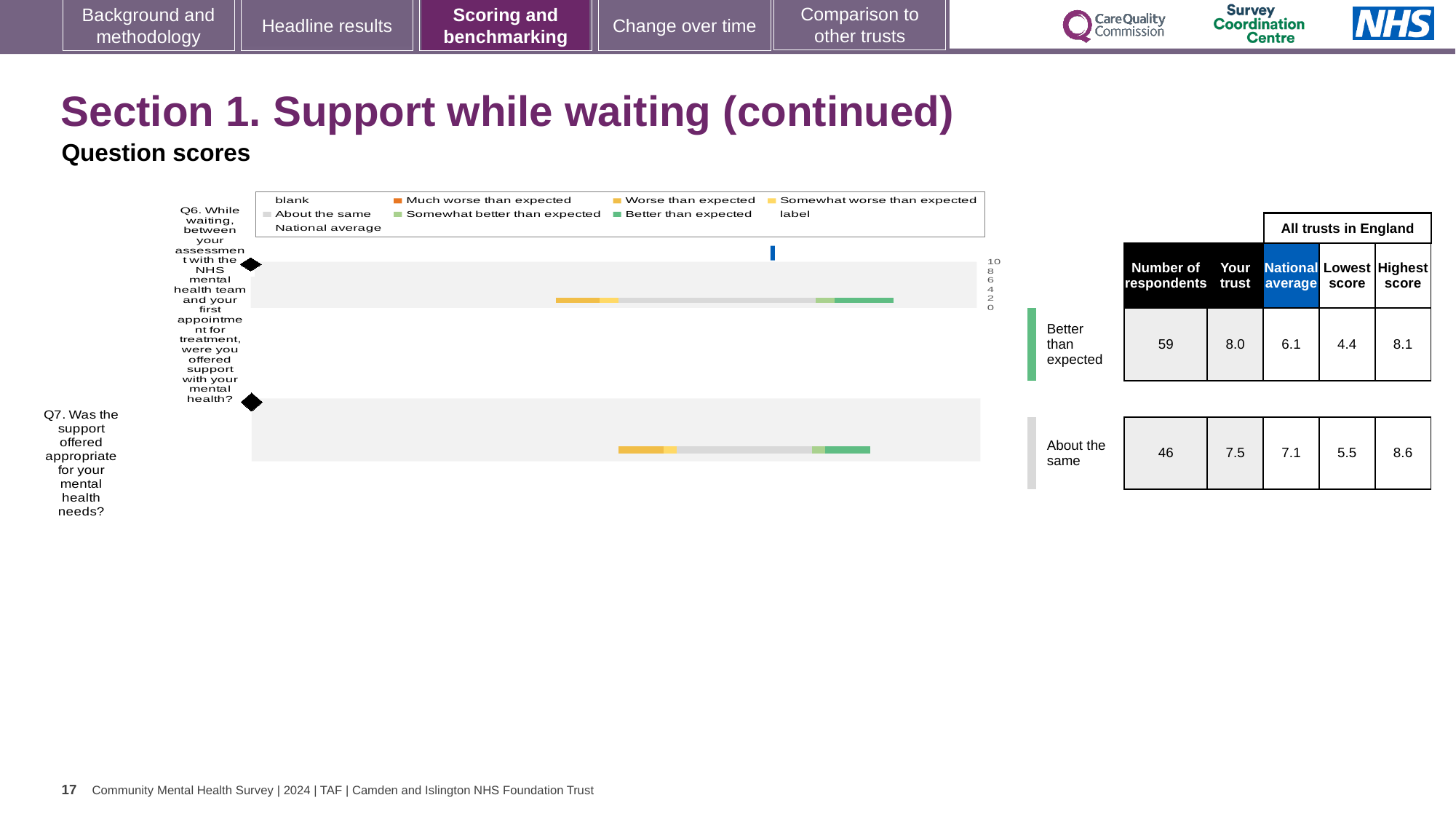
Which question had more respondents, Q6 or Q7? Q6 How many questions (bars) are plotted in the question scores chart? 2 In the chart legend, what colour represents 'Better than expected'? green What benchmark category is shown for Q7? About the same For Q6, which is larger: the 'Your trust' score or the national average? Your trust What is the difference between the 'Your trust' score and the national average for Q6? 1.9 What is the national average score for Q6? 6.1 What is the highest score among all trusts in England for Q7? 8.6 What is the lowest score among all trusts in England for Q6? 4.4 How many respondents answered Q7 (was the support offered appropriate for your mental health needs)? 46 What is the 'Your trust' score for Q6 (support while waiting between assessment and first appointment)? 8.0 What kind of chart is used to show the question scores for Q6 and Q7? bar chart